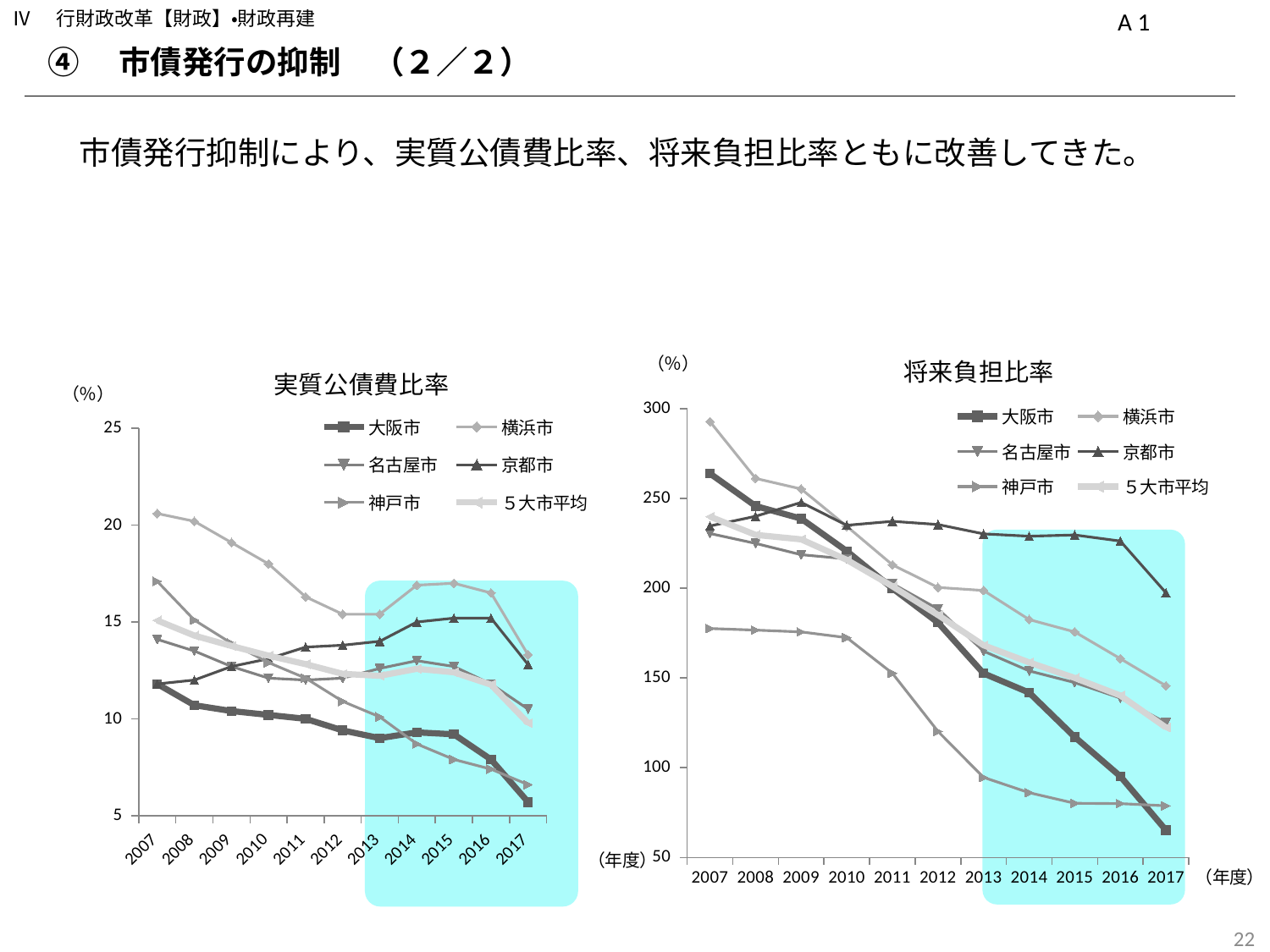
What kind of chart is the 実質公債費比率 chart on the left? line chart How many series does the legend of the 将来負担比率 chart list? 6 What is the title of the chart on the right side of the slide? 将来負担比率 In the 将来負担比率 chart, which city has the lowest value in 2017? 大阪市 In the 将来負担比率 chart, does the 大阪市 line rise or fall from 2007 to 2017? fall How many years are plotted along the x axis of the 実質公債費比率 chart? 11 In the 将来負担比率 chart, which is larger in 2017, 京都市 or 横浜市? 京都市 In the 将来負担比率 chart, is the value for 大阪市 in 2017 greater or less than 100? less In the 実質公債費比率 chart, which city has the highest value in 2007? 横浜市 In the 将来負担比率 chart, which city has the highest value in 2007? 横浜市 In the 実質公債費比率 chart, which is larger in 2007, 横浜市 or 神戸市? 横浜市 In the 実質公債費比率 chart, is the value for 横浜市 in 2007 greater or less than 20? greater